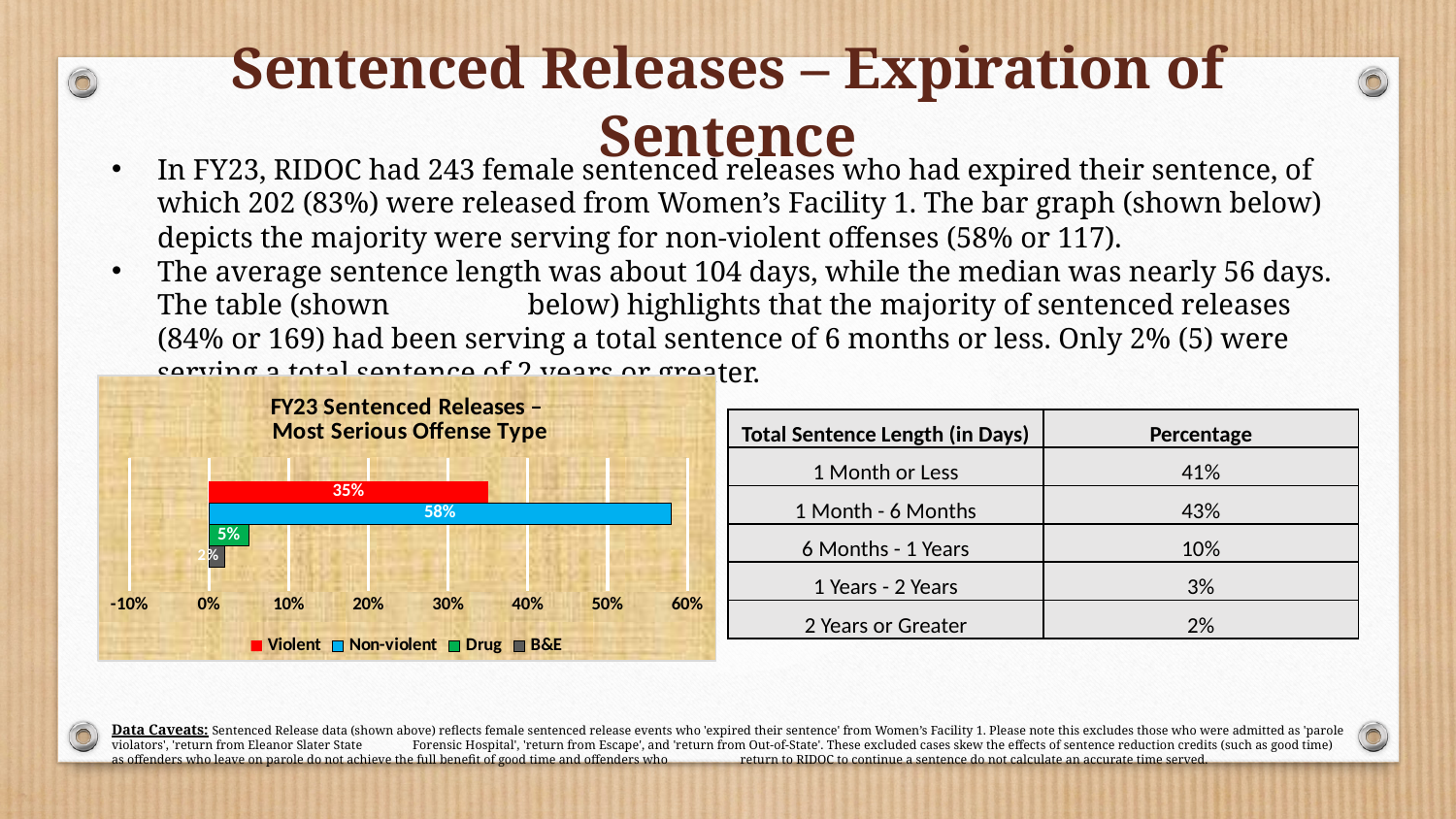
Which offense type has the highest percentage in the chart? Non-violent Which is larger, the Drug bar or the B&E bar? Drug What percentage of FY23 sentenced releases had a violent most serious offense type? 35% What percentage of FY23 sentenced releases had a non-violent most serious offense type? 58% What is the title of the bar chart? FY23 Sentenced Releases – Most Serious Offense Type Which offense type has the lowest percentage in the chart? B&E What is the difference in percentage points between the Non-violent and Violent bars? 23% How many series does the chart legend list? 4 What percentage of FY23 sentenced releases had B&E as the most serious offense type? 2% Is the value for Violent greater or less than 40%? less What percentage of FY23 sentenced releases had a drug most serious offense type? 5% What kind of chart is shown on the slide? bar chart